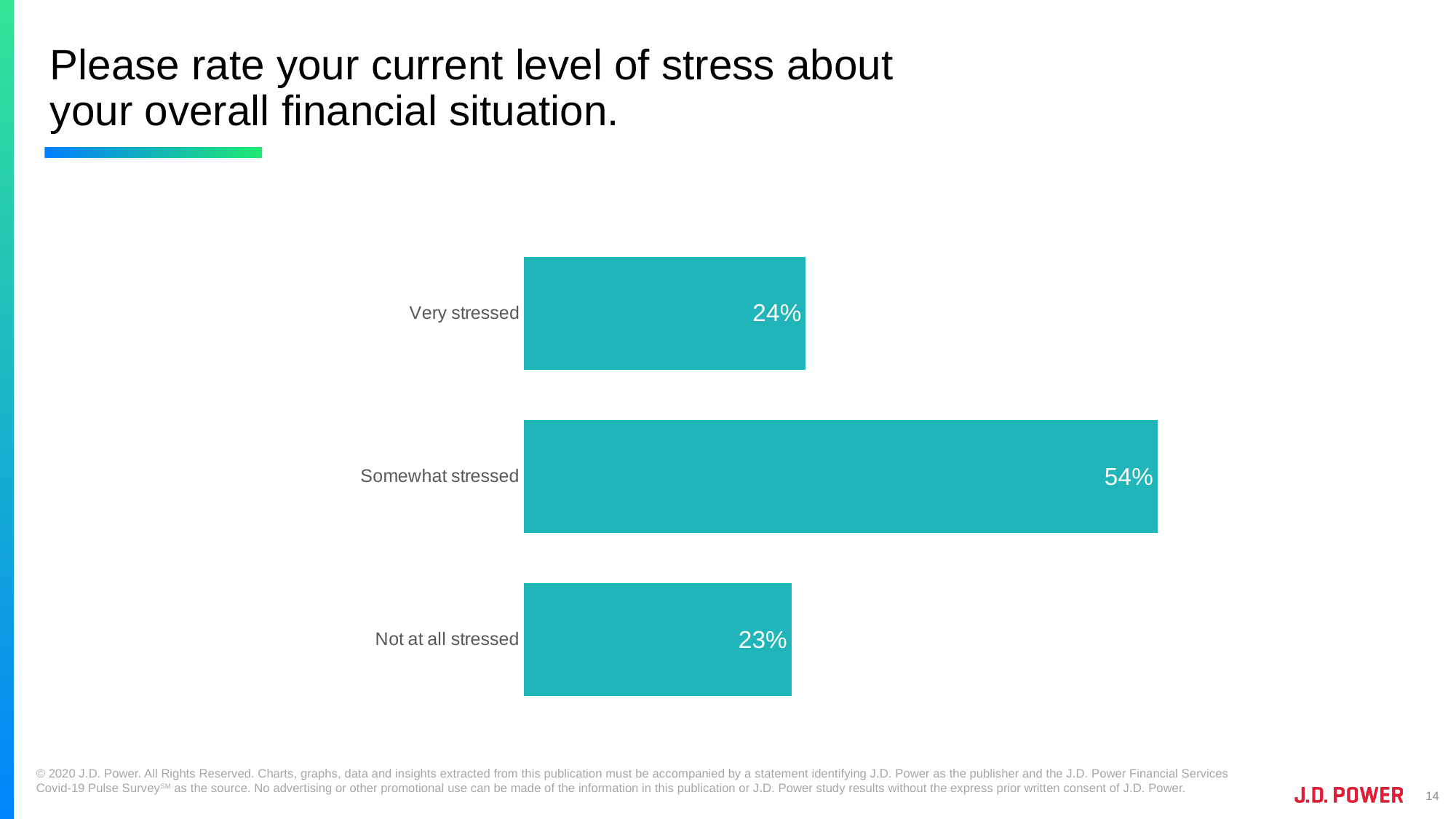
What is the combined percentage of respondents who are very stressed or somewhat stressed? 78% Which stress level has the lowest percentage of respondents? Not at all stressed What percentage of respondents said they are somewhat stressed? 54% What percentage of respondents said they are not at all stressed? 23% What colour are the bars in the chart? Teal Which stress level has the highest percentage of respondents? Somewhat stressed What is the difference in percentage points between somewhat stressed and very stressed? 30 How many stress level categories are shown in the chart? 3 What percentage of respondents said they are very stressed? 24% What kind of chart is shown on the slide? Bar chart What is the difference in percentage points between very stressed and not at all stressed? 1 Which is larger, the percentage for somewhat stressed or the percentage for not at all stressed? Somewhat stressed